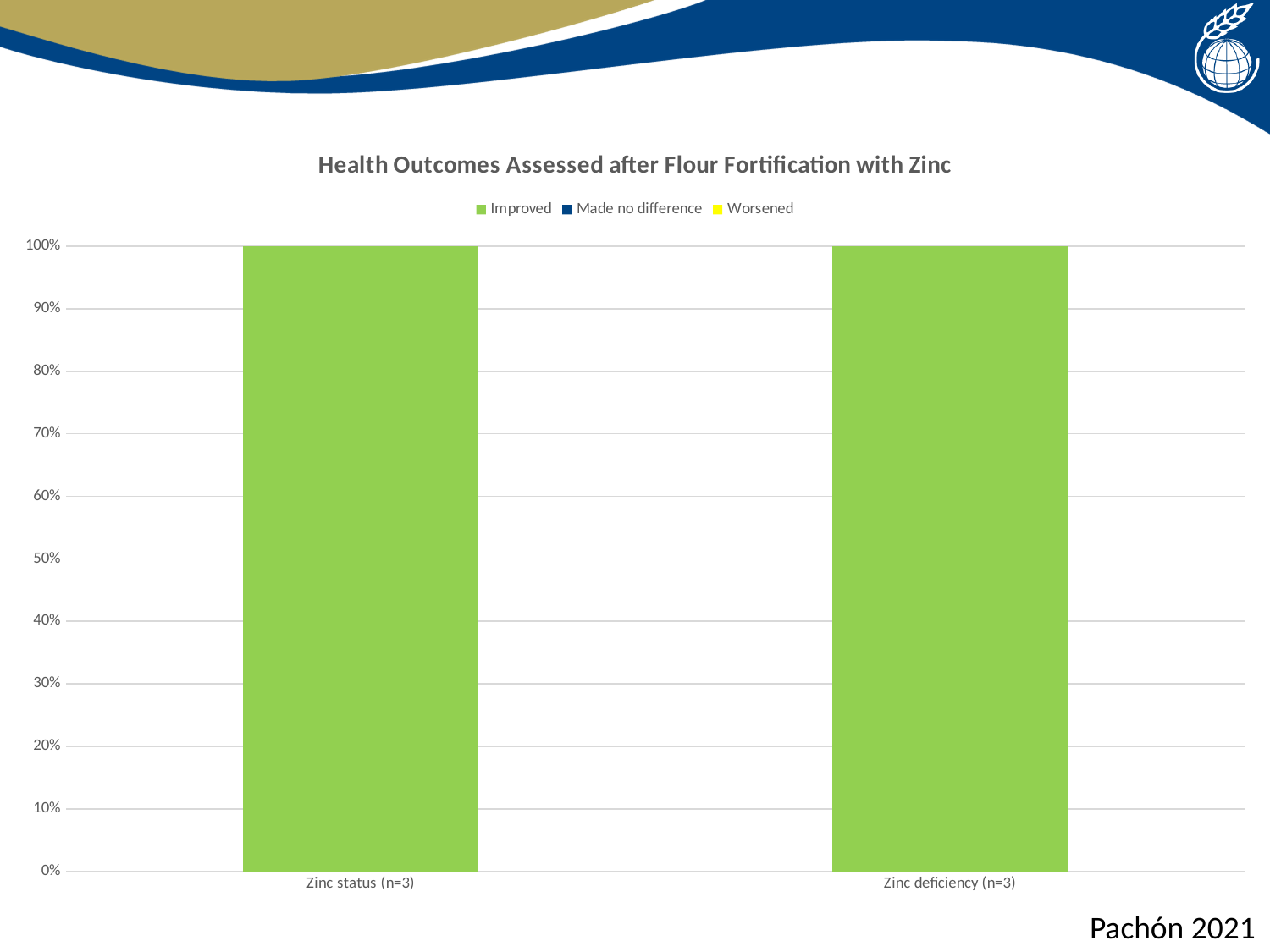
What kind of chart is shown on the slide? Bar chart Is the Improved value for Zinc deficiency (n=3) greater or less than 90%? greater What is the title of the chart? Health Outcomes Assessed after Flour Fortification with Zinc What is the highest value shown on the y axis? 100% Is the Improved value for Zinc status (n=3) greater or less than 50%? greater How many series does the legend list? 3 What share of the Zinc deficiency (n=3) bar is Improved? 100% What are the three series listed in the legend? Improved, Made no difference, Worsened What share of the Zinc status (n=3) bar is Improved? 100% Which series makes up the entire bar for Zinc status (n=3)? Improved How many categories are shown on the x axis? 2 What is the total height of the Zinc deficiency (n=3) stacked bar? 100%